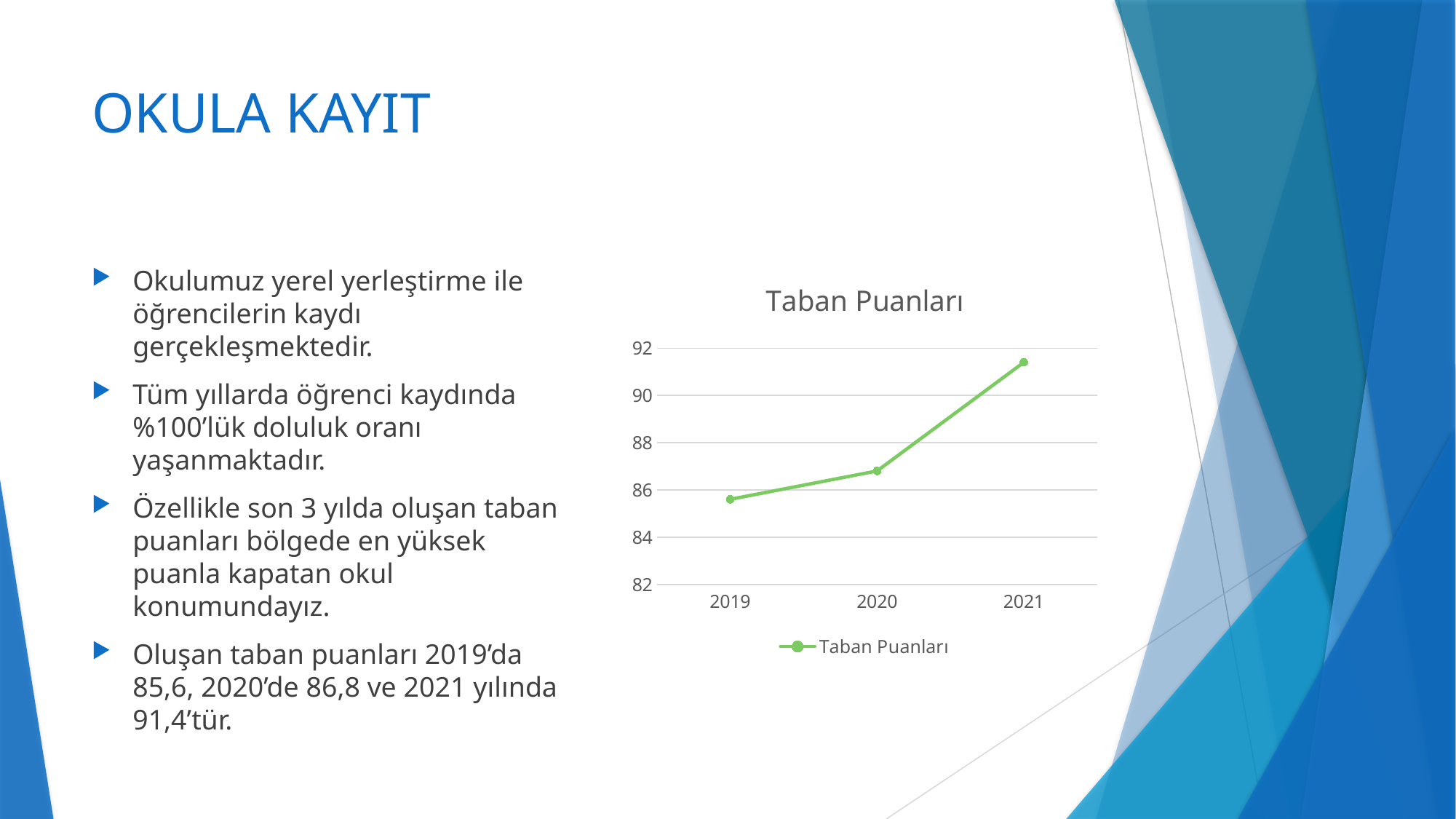
Do the Taban Puanları values rise or fall from 2019 to 2021? rise According to the values stated on the slide, what is the difference between the 2021 and 2019 taban puanları? 5,8 Is the value for 2019 greater or less than 86? less What is the title of the chart? Taban Puanları Which is larger, the value for 2020 or the value for 2019? 2020 What kind of chart is shown on the slide? line chart How many series does the chart legend list? 1 How many years are plotted on the x axis of the chart? 3 Which year has the highest Taban Puanları value? 2021 Is the value for 2021 greater or less than 90? greater According to the slide, what is the taban puanı for 2021? 91,4 Which year has the lowest Taban Puanları value? 2019